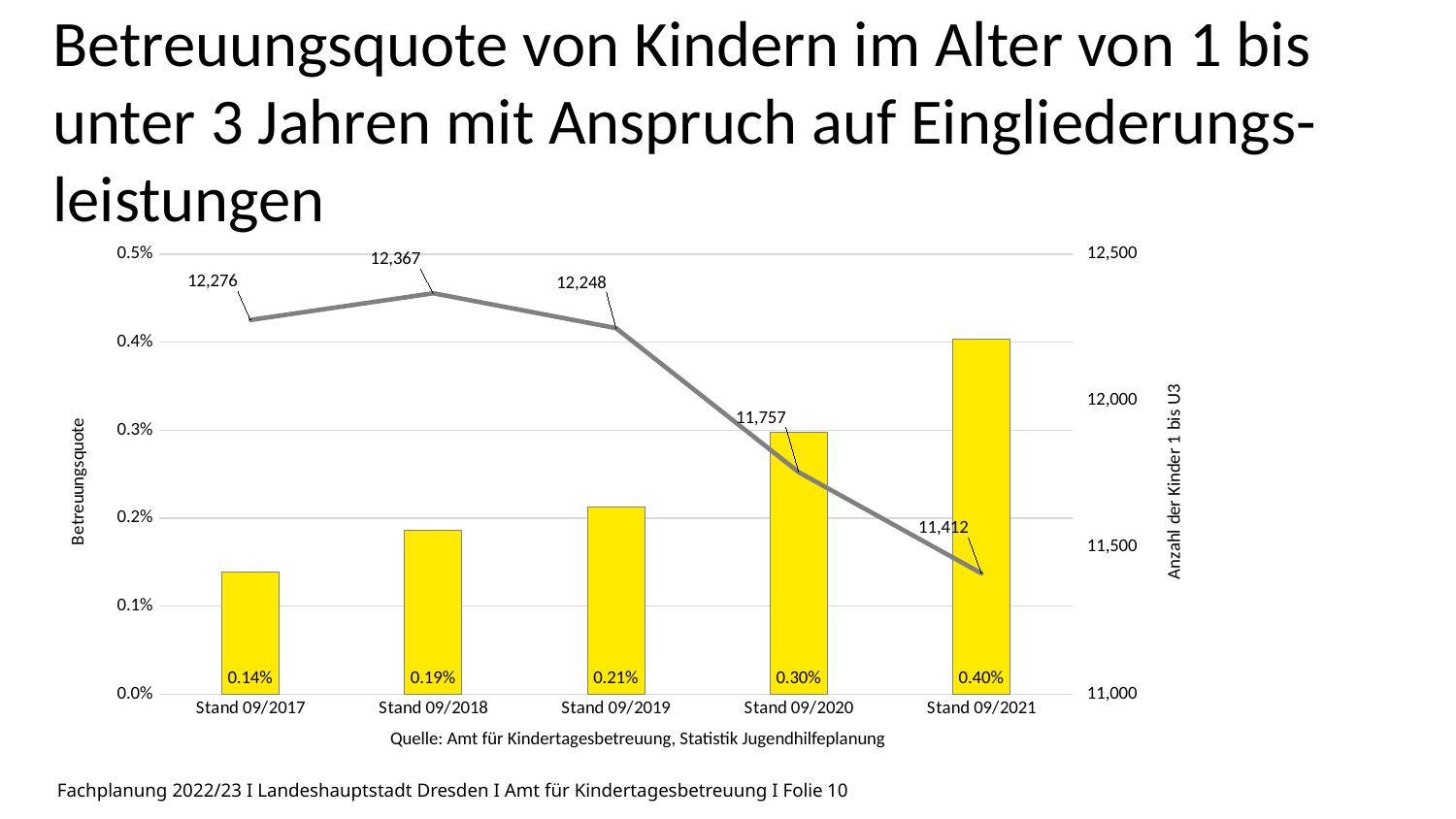
Which Stand has the highest Anzahl der Kinder 1 bis U3? Stand 09/2018 Which Stand has the lowest Anzahl der Kinder 1 bis U3? Stand 09/2021 What is the Betreuungsquote for Stand 09/2021? 0.40% Is the Anzahl der Kinder 1 bis U3 larger for Stand 09/2017 or Stand 09/2019? Stand 09/2017 How does the Betreuungsquote change from Stand 09/2017 to Stand 09/2021? It rises What is the title of the right-hand vertical axis? Anzahl der Kinder 1 bis U3 How many Stand categories are shown on the x axis? 5 What is the Betreuungsquote for Stand 09/2019? 0.21% What is the difference in Betreuungsquote between Stand 09/2021 and Stand 09/2017? 0.26% What is the Anzahl der Kinder 1 bis U3 for Stand 09/2020? 11,757 What is the difference in Anzahl der Kinder 1 bis U3 between Stand 09/2018 and Stand 09/2021? 955 Which Stand has the highest Betreuungsquote? Stand 09/2021